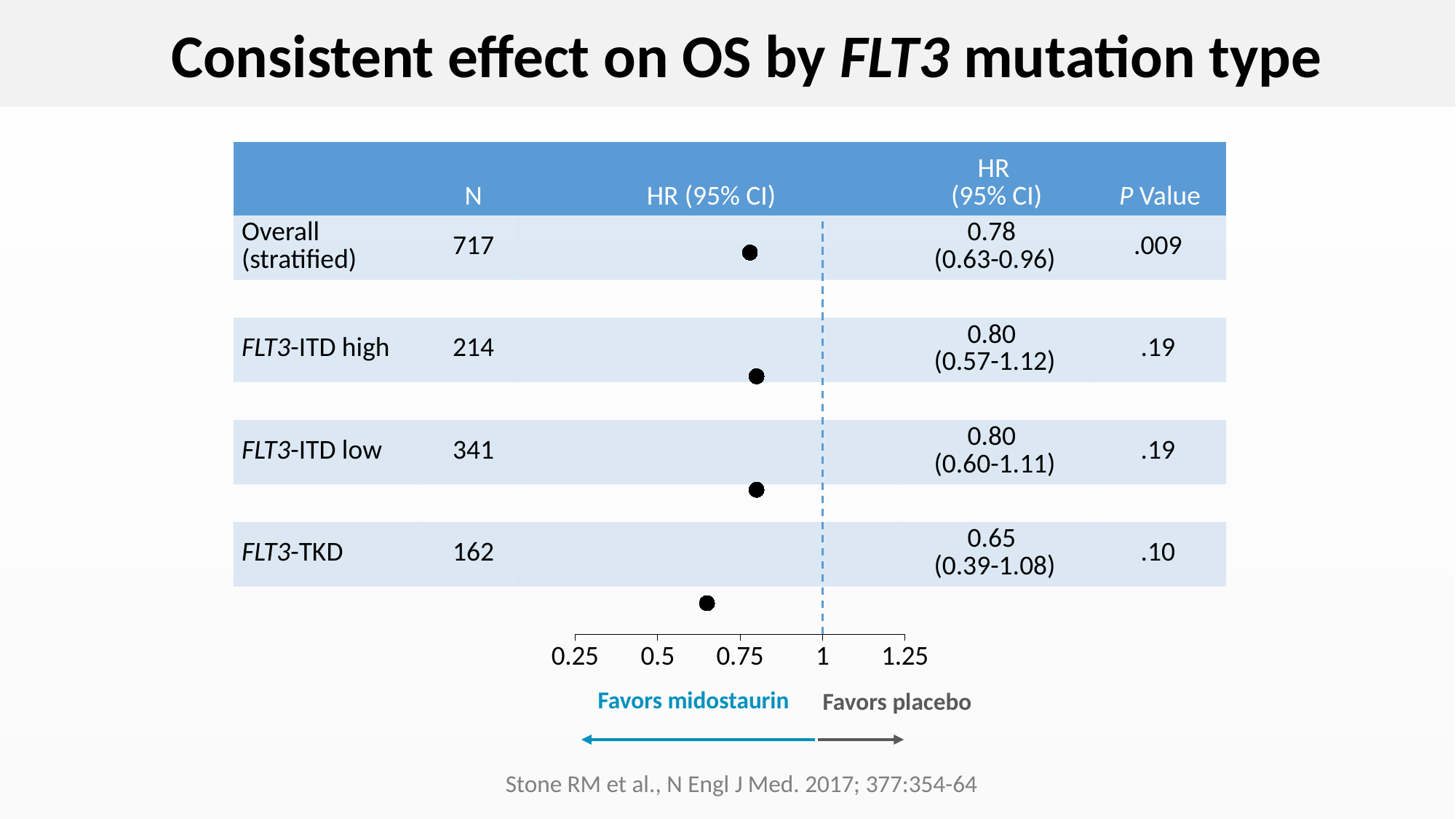
What is the difference between the HR for FLT3-ITD high and the HR for FLT3-TKD? 0.15 Which row has the largest N? Overall (stratified) How many rows (subgroups including overall) are plotted in the forest plot? 4 What is the hazard ratio (HR) for the FLT3-TKD subgroup? 0.65 What label appears under the left-pointing arrow below the axis? Favors midostaurin Which row has the lowest hazard ratio? FLT3-TKD What is N for the FLT3-ITD low subgroup? 341 What is the P value for the Overall (stratified) row? .009 Is the HR point for FLT3-TKD greater or less than 0.75 on the axis? less What kind of chart is shown on the slide? forest plot Which has the larger hazard ratio, Overall (stratified) or FLT3-TKD? Overall (stratified) What is the 95% CI for the HR in the FLT3-ITD high subgroup? 0.57-1.12